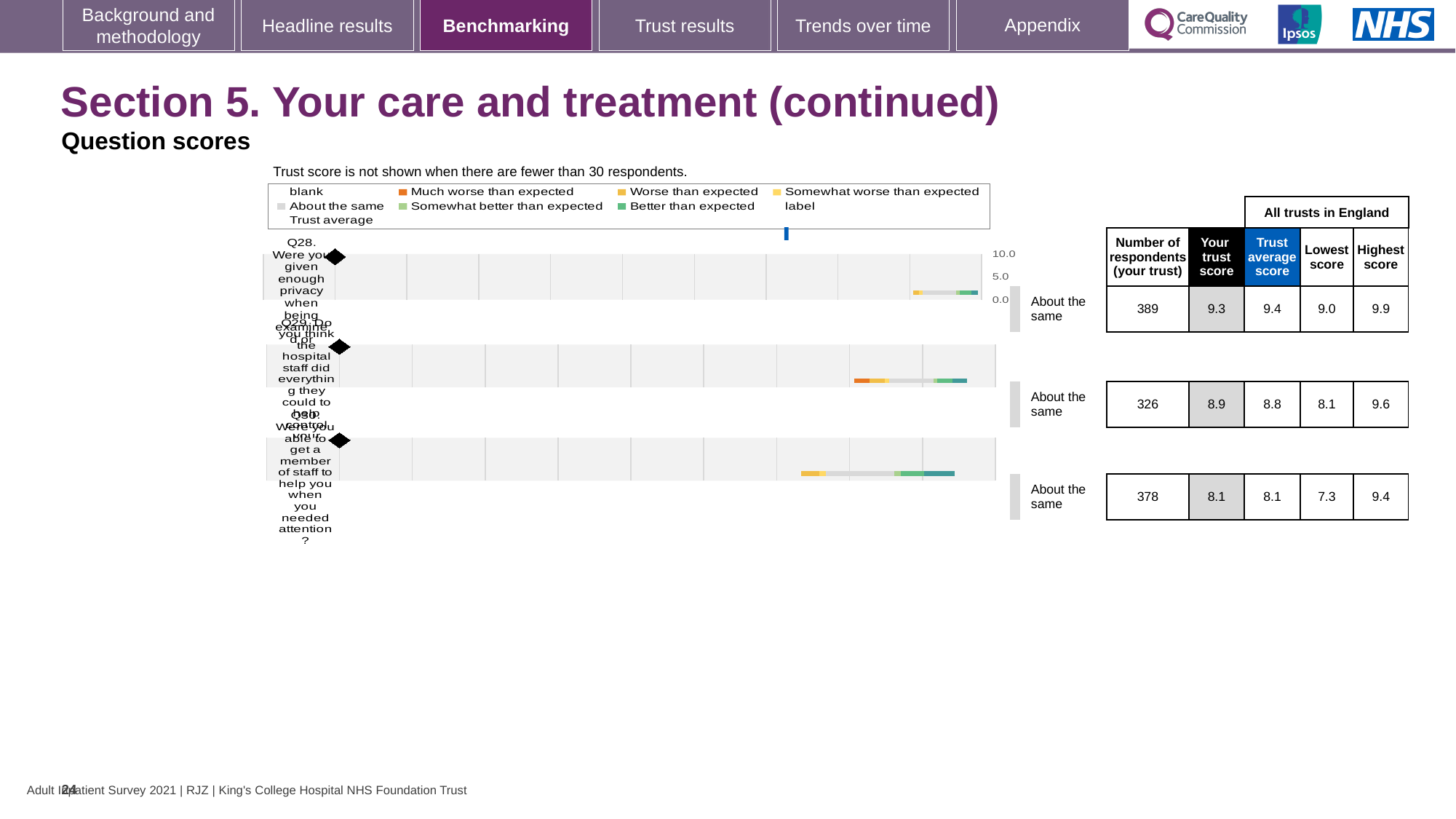
Which question has the lowest trust score? Q30 What is the difference between the trust average score and this trust's score for Q28? 0.1 For Q29, which is larger: this trust's score or the trust average score? This trust's score (8.9) What is the highest score across all trusts in England for Q30? 9.4 What is the trust score for Q28 (Were you given enough privacy when being examined or treated)? 9.3 How many respondents answered Q29 for this trust? 326 What benchmark category is shown for Q30? About the same Which question has the highest trust score? Q28 What is the lowest score across all trusts in England for Q29? 8.1 What kind of chart is used to show the question scores? Bar chart Is the trust score for Q30 greater or less than 5.0? greater How many questions are plotted on the chart? 3